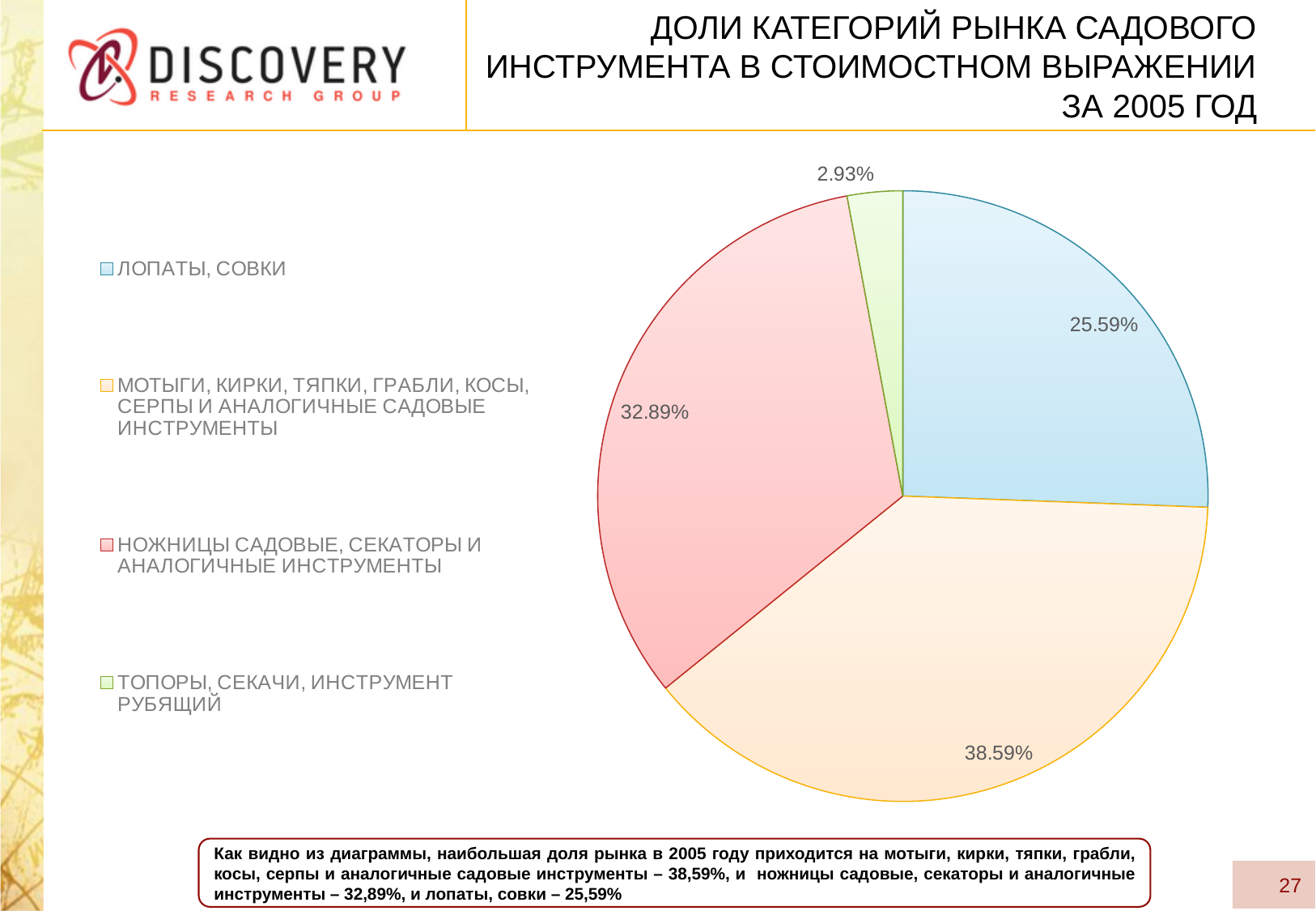
What share of the pie does МОТЫГИ, КИРКИ, ТЯПКИ, ГРАБЛИ, КОСЫ, СЕРПЫ И АНАЛОГИЧНЫЕ САДОВЫЕ ИНСТРУМЕНТЫ have? 38.59% What share of the pie does НОЖНИЦЫ САДОВЫЕ, СЕКАТОРЫ И АНАЛОГИЧНЫЕ ИНСТРУМЕНТЫ have? 32.89% What kind of chart is shown on the slide? pie chart What colour is the slice for ЛОПАТЫ, СОВКИ in the pie chart? light blue How many categories are shown in the pie chart? 4 Which category has the smallest share of the pie? ТОПОРЫ, СЕКАЧИ, ИНСТРУМЕНТ РУБЯЩИЙ Which category has the largest share of the pie? МОТЫГИ, КИРКИ, ТЯПКИ, ГРАБЛИ, КОСЫ, СЕРПЫ И АНАЛОГИЧНЫЕ САДОВЫЕ ИНСТРУМЕНТЫ What is the difference in percentage points between the share of МОТЫГИ, КИРКИ, ТЯПКИ, ГРАБЛИ, КОСЫ, СЕРПЫ И АНАЛОГИЧНЫЕ САДОВЫЕ ИНСТРУМЕНТЫ and the share of ЛОПАТЫ, СОВКИ? 13 percentage points What is the difference in percentage points between the share of НОЖНИЦЫ САДОВЫЕ, СЕКАТОРЫ И АНАЛОГИЧНЫЕ ИНСТРУМЕНТЫ and the share of ТОПОРЫ, СЕКАЧИ, ИНСТРУМЕНТ РУБЯЩИЙ? 29.96 percentage points Which has a larger share: ЛОПАТЫ, СОВКИ or НОЖНИЦЫ САДОВЫЕ, СЕКАТОРЫ И АНАЛОГИЧНЫЕ ИНСТРУМЕНТЫ? НОЖНИЦЫ САДОВЫЕ, СЕКАТОРЫ И АНАЛОГИЧНЫЕ ИНСТРУМЕНТЫ What share of the pie does ЛОПАТЫ, СОВКИ have? 25.59%